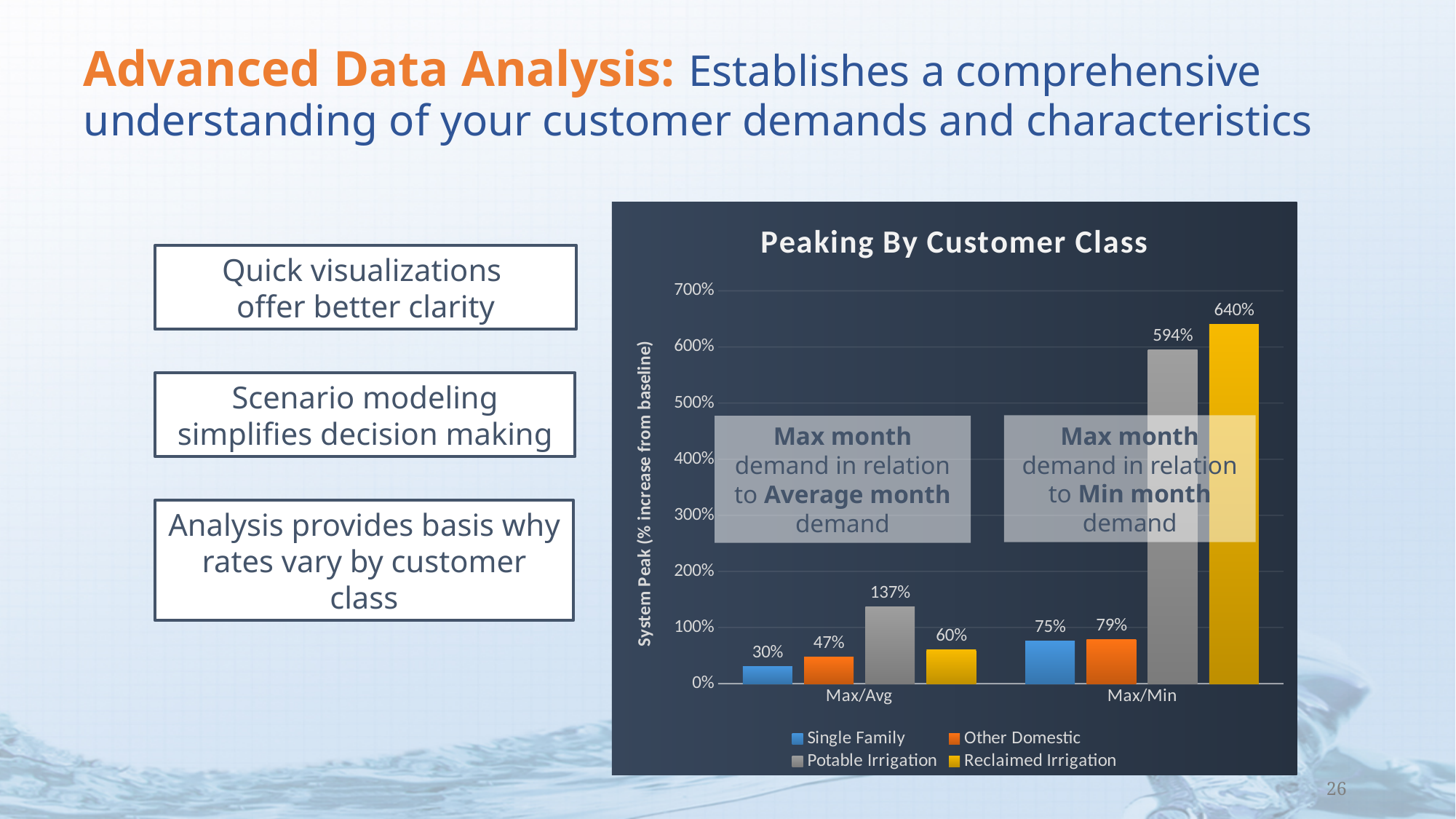
Which is larger: Potable Irrigation in Max/Avg or Other Domestic in Max/Min? Potable Irrigation in Max/Avg What is the value for Single Family in the Max/Avg group? 30% What is the value for Potable Irrigation in the Max/Min group? 594% What kind of chart is shown on the slide? Bar chart What is the difference between the Other Domestic values in the Max/Min and Max/Avg groups? 32% What is the value for Reclaimed Irrigation in the Max/Avg group? 60% How many series does the legend list? 4 What is the difference between the Reclaimed Irrigation and Potable Irrigation values in the Max/Min group? 46% Which series has the lowest value in the Max/Avg group? Single Family How many categories are shown on the x axis? 2 Which series has the highest value in the Max/Min group? Reclaimed Irrigation What is the title of the chart? Peaking By Customer Class